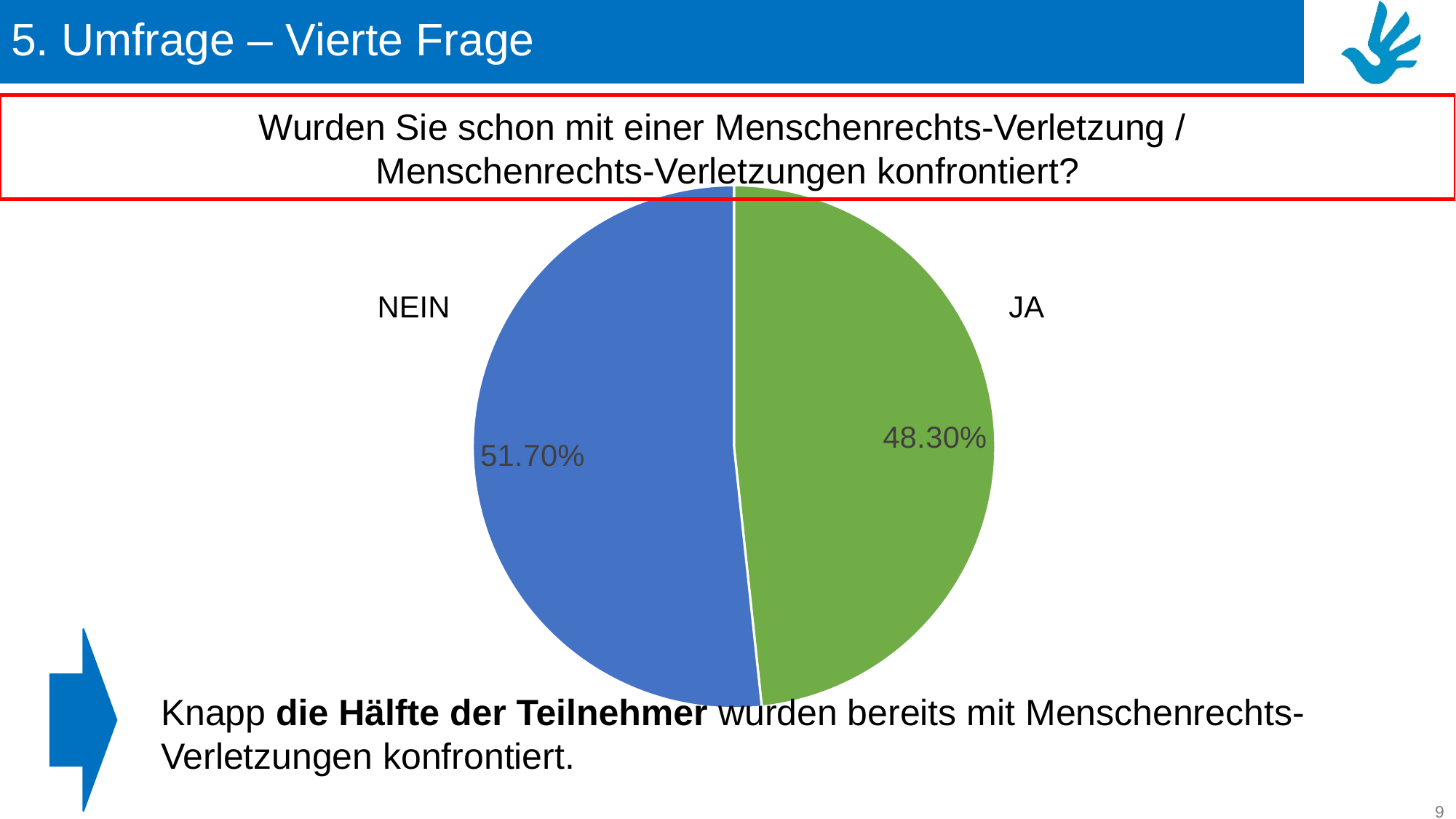
Which is larger, the share for JA or the share for NEIN? NEIN What share of the pie does the JA slice represent? 48.30% What percentage of respondents answered NEIN? 51.70% Which slice of the pie is the largest? NEIN How many slices does the pie chart have? 2 What is the difference in percentage points between the NEIN and JA slices? 3.40% Which slice of the pie is the smallest? JA What kind of chart is shown on the slide? pie chart What colour is the NEIN slice? blue What percentage of respondents answered JA? 48.30% What colour is the JA slice? green